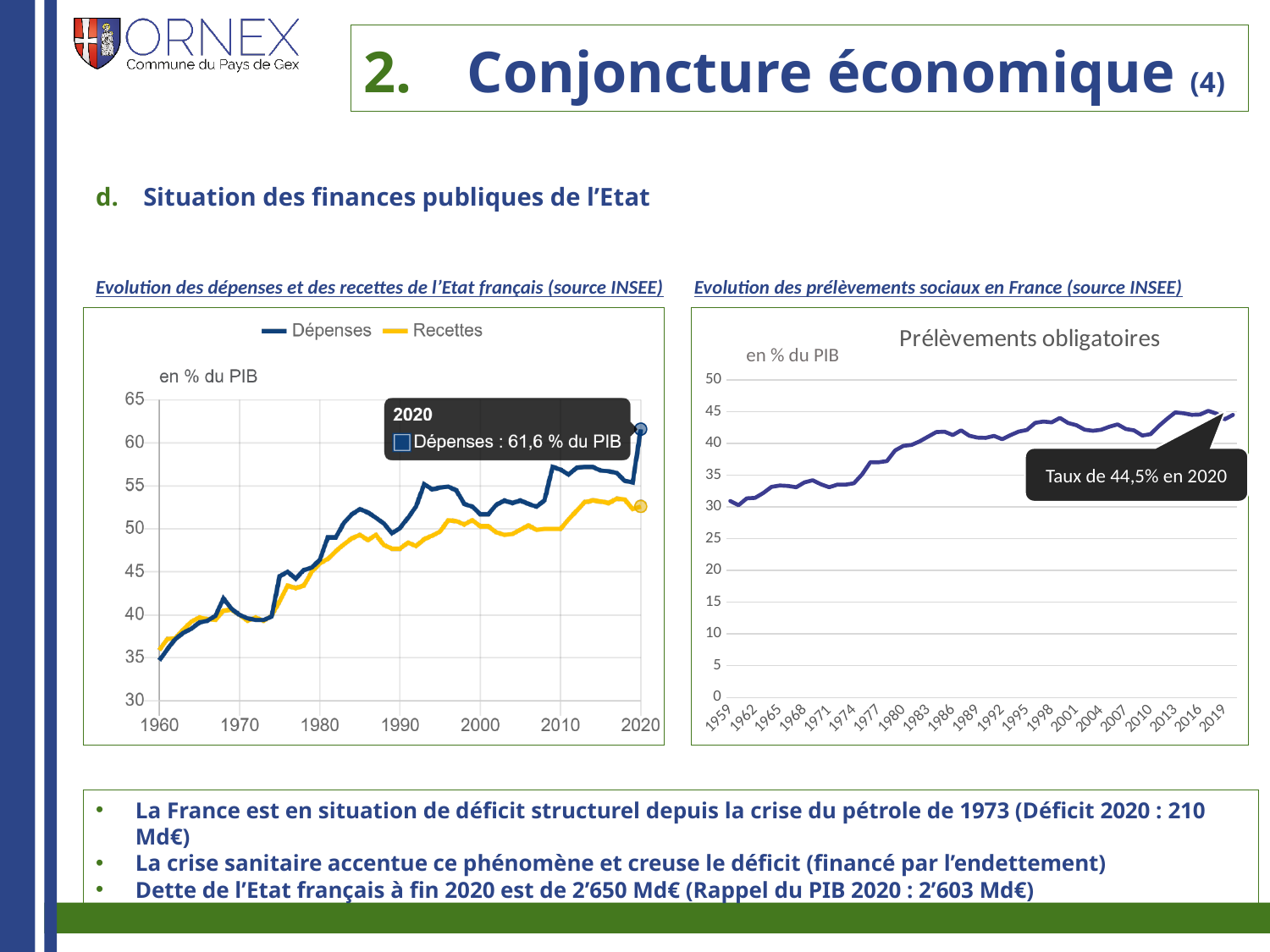
On the left chart (Evolution des dépenses et des recettes de l'Etat français), what kind of chart is it? Line chart On the left chart (Evolution des dépenses et des recettes de l'Etat français), what are the two legend entries? Dépenses and Recettes On the right chart (Prélèvements obligatoires), do the values overall rise or fall from 1959 to 2019? Rise On the left chart (Evolution des dépenses et des recettes de l'Etat français), how many series does the legend list? 2 On the left chart (Evolution des dépenses et des recettes de l'Etat français), is the value for Recettes in 2020 greater or less than 55? less On the right chart (Prélèvements obligatoires), what kind of chart is it? Line chart On the left chart (Evolution des dépenses et des recettes de l'Etat français), is the value for Dépenses in 1960 greater or less than 40? less On the right chart (Prélèvements obligatoires), what is the rate in 2020? 44,5% On the left chart (Evolution des dépenses et des recettes de l'Etat français), what is the value of Dépenses in 2020? 61,6 % du PIB On the right chart (Prélèvements obligatoires), is the value for 1959 greater or less than 35? less On the left chart (Evolution des dépenses et des recettes de l'Etat français), which series is higher in 2020, Dépenses or Recettes? Dépenses On the left chart (Evolution des dépenses et des recettes de l'Etat français), do the Dépenses values overall rise or fall from 1960 to 2020? Rise